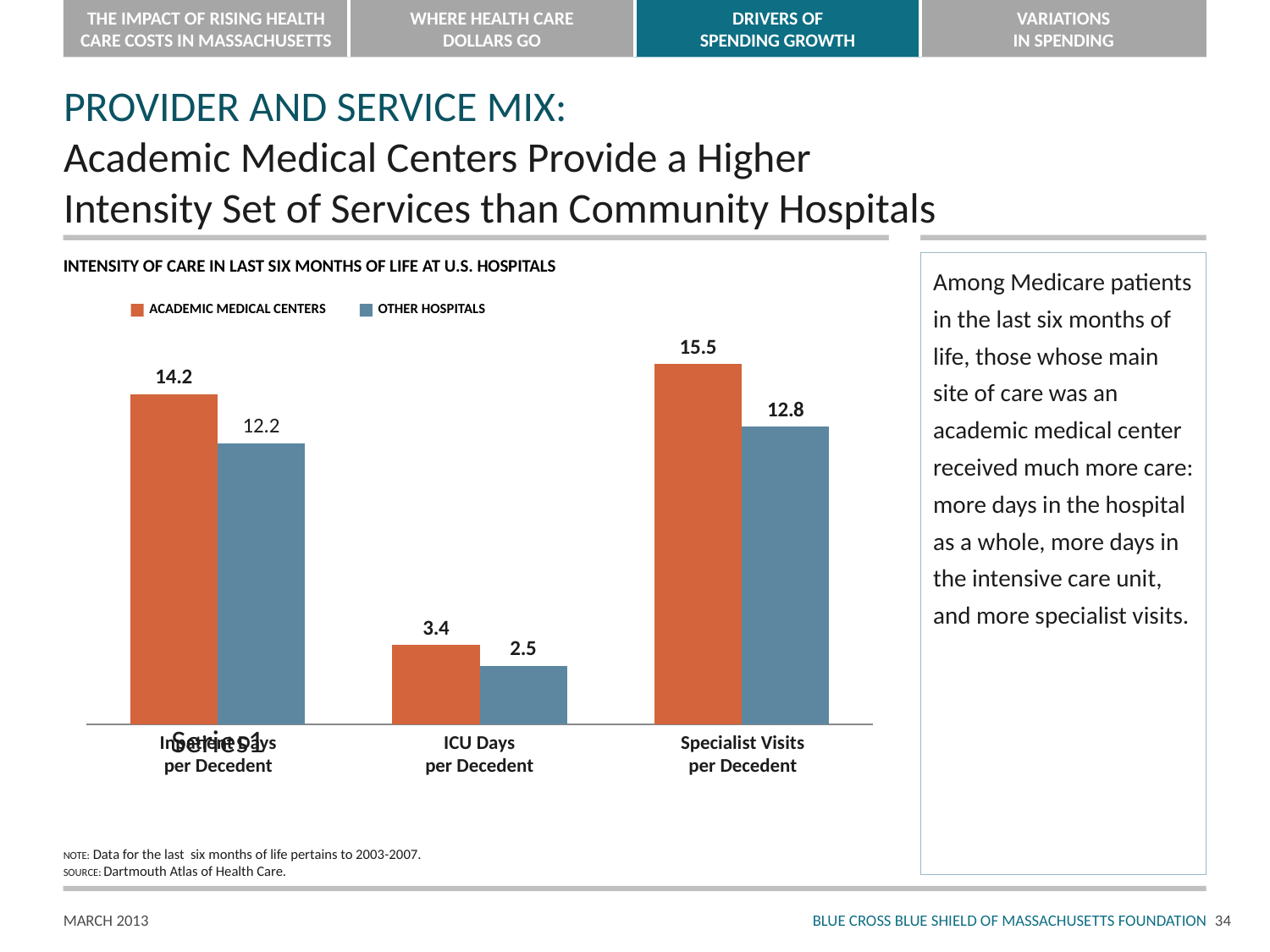
What kind of chart is shown on the slide? Bar chart What is the value for Academic Medical Centers for ICU Days per Decedent? 3.4 How many categories are shown on the x axis of the chart? 3 Which category has the highest value for Academic Medical Centers? Specialist Visits per Decedent Which category has the lowest value for Other Hospitals? ICU Days per Decedent What is the value for Academic Medical Centers for Specialist Visits per Decedent? 15.5 What is the value for Other Hospitals for ICU Days per Decedent? 2.5 What is the difference between Academic Medical Centers and Other Hospitals for Inpatient Days per Decedent? 2.0 How many series does the chart legend list? 2 Which is larger for ICU Days per Decedent: Academic Medical Centers or Other Hospitals? Academic Medical Centers What is the value for Other Hospitals for Inpatient Days per Decedent? 12.2 What is the difference between Academic Medical Centers and Other Hospitals for Specialist Visits per Decedent? 2.7